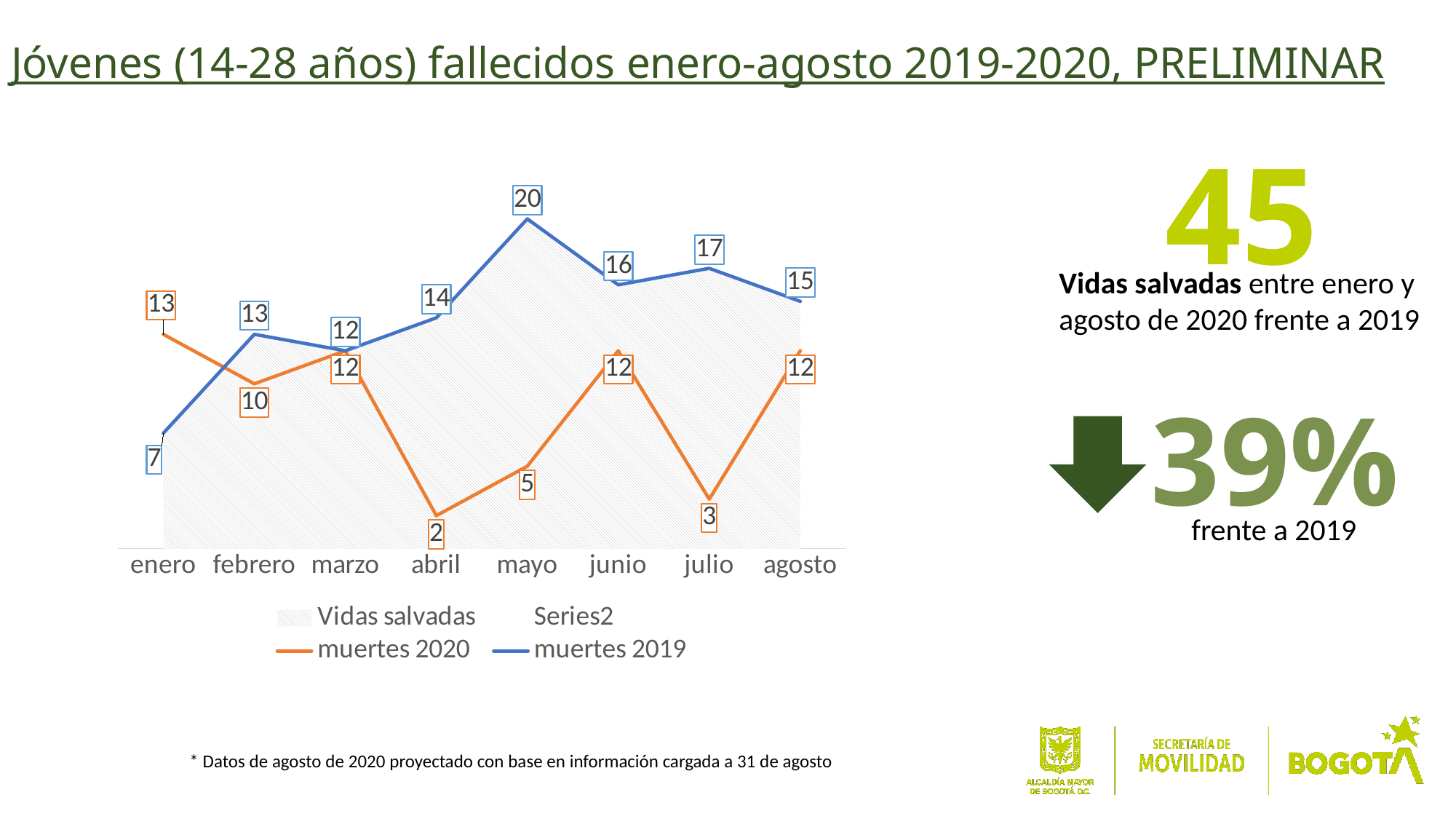
How many entries does the legend list? 4 Which is larger in enero, muertes 2019 or muertes 2020? muertes 2020 What is the difference between muertes 2019 and muertes 2020 in mayo? 15 What is the value for muertes 2020 in julio? 3 In which month is muertes 2019 highest? mayo Does muertes 2019 rise or fall from enero to febrero? rise What kind of chart is shown? combination area and line chart What is the value for muertes 2020 in abril? 2 In which month is muertes 2020 lowest? abril How many months are shown on the x axis? 8 What is the value for muertes 2019 in enero? 7 What is the value for muertes 2019 in mayo? 20